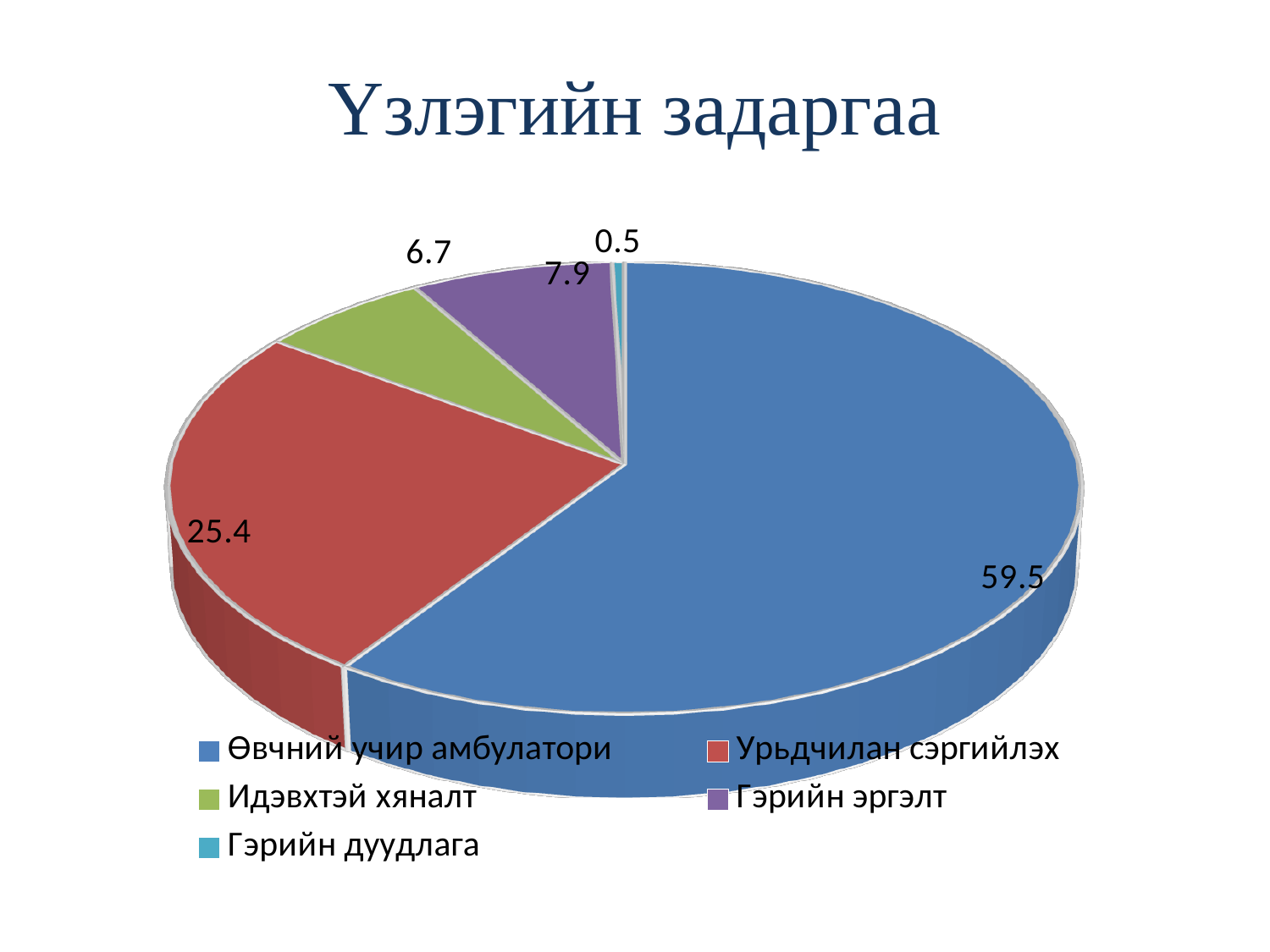
What type of chart is shown on the slide? pie chart What is the value for Идэвхтэй хяналт? 6.7 Which is larger, Гэрийн эргэлт or Идэвхтэй хяналт? Гэрийн эргэлт What is the title of the chart? Үзлэгийн задаргаа What is the value for Өвчний учир амбулатори? 59.5 What is the value for Гэрийн эргэлт? 7.9 What is the value for Урьдчилан сэргийлэх? 25.4 Which category has the largest slice? Өвчний учир амбулатори How many categories does the legend list? 5 Which category has the smallest slice? Гэрийн дуудлага What is the difference between the values for Өвчний учир амбулатори and Урьдчилан сэргийлэх? 34.1 What is the value for Гэрийн дуудлага? 0.5